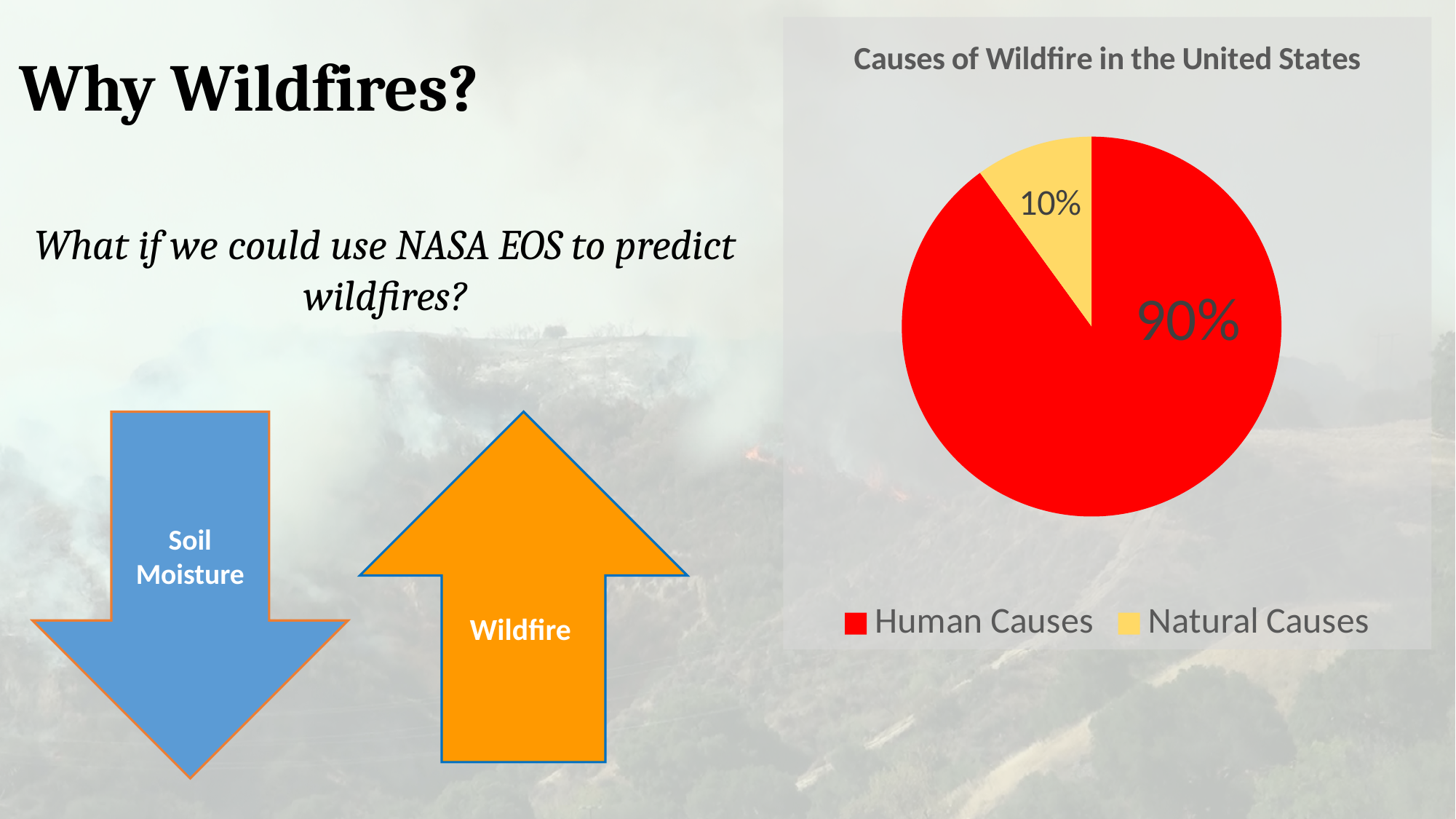
What is the difference in percentage points between Human Causes and Natural Causes? 80 How many entries does the legend list? 2 Which is larger, the share for Human Causes or the share for Natural Causes? Human Causes What colour represents Natural Causes in the pie chart? yellow How many slices does the pie chart have? 2 What share of wildfires is attributed to Human Causes? 90% Which cause accounts for the largest share of wildfires? Human Causes What is the title of the chart? Causes of Wildfire in the United States What share of wildfires is attributed to Natural Causes? 10% Which cause accounts for the smallest share of wildfires? Natural Causes What kind of chart is shown on the slide? pie chart